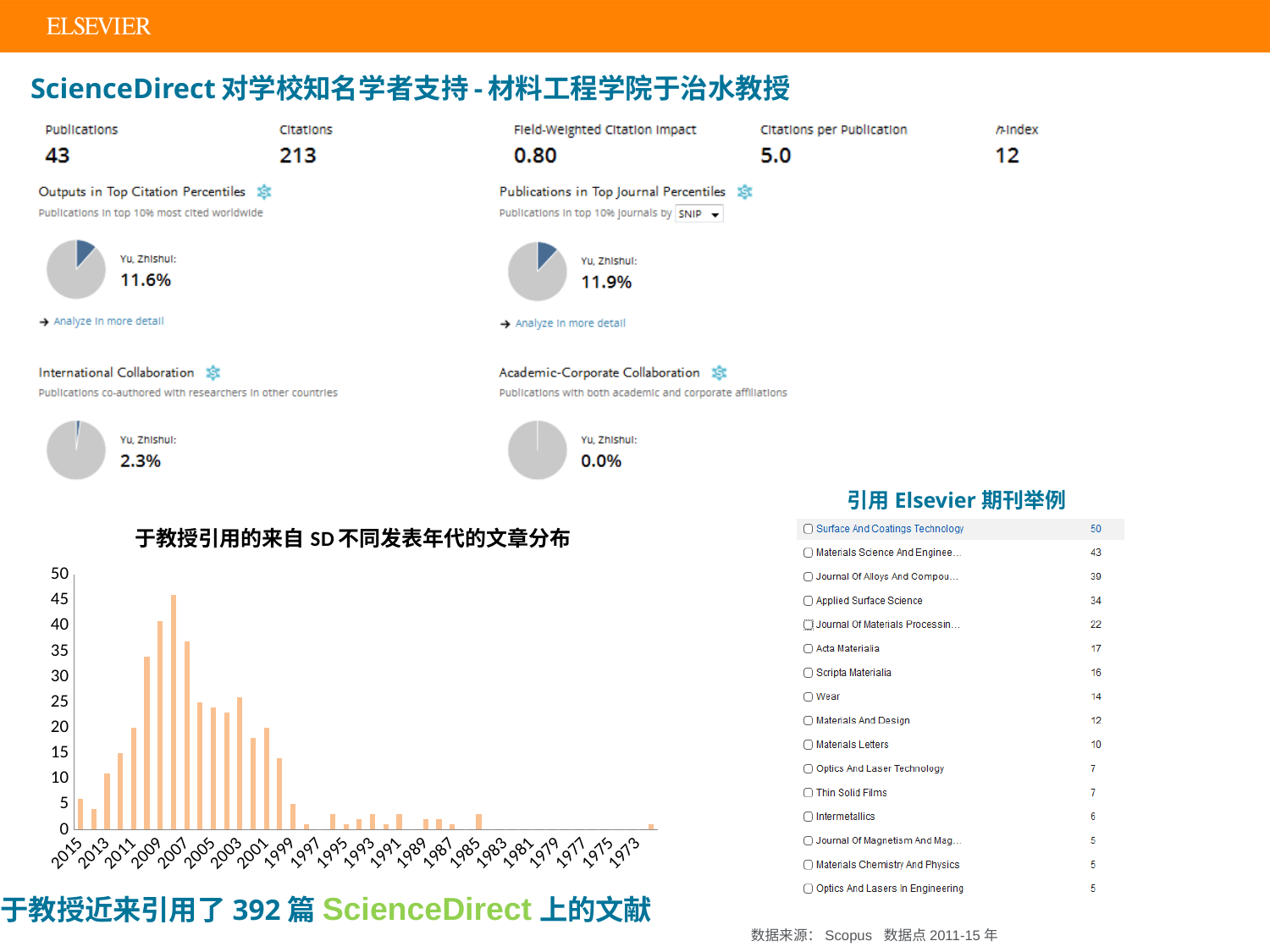
In the "Academic-Corporate Collaboration" pie chart, what share is shown for Yu, Zhishui? 0.0% In the bar chart "于教授引用的来自 SD 不同发表年代的文章分布", which has the larger value, 2009 or 2015? 2009 In the bar chart "于教授引用的来自 SD 不同发表年代的文章分布", is the value for 2005 greater or less than 20? greater In the "Publications in Top Journal Percentiles" pie chart, what share is shown for Yu, Zhishui? 11.9% In the bar chart "于教授引用的来自 SD 不同发表年代的文章分布", do the values generally rise or fall moving along the x axis from 2007 to 1973? fall In the "Outputs in Top Citation Percentiles" pie chart, what share is shown for Yu, Zhishui? 11.6% In the bar chart "于教授引用的来自 SD 不同发表年代的文章分布", is the value for 2009 greater or less than 35? greater In the bar chart "于教授引用的来自 SD 不同发表年代的文章分布", is the value for 2015 greater or less than 10? less What kind of chart is "于教授引用的来自 SD 不同发表年代的文章分布"? bar chart In the bar chart "于教授引用的来自 SD 不同发表年代的文章分布", what is the highest value shown on the y axis? 50